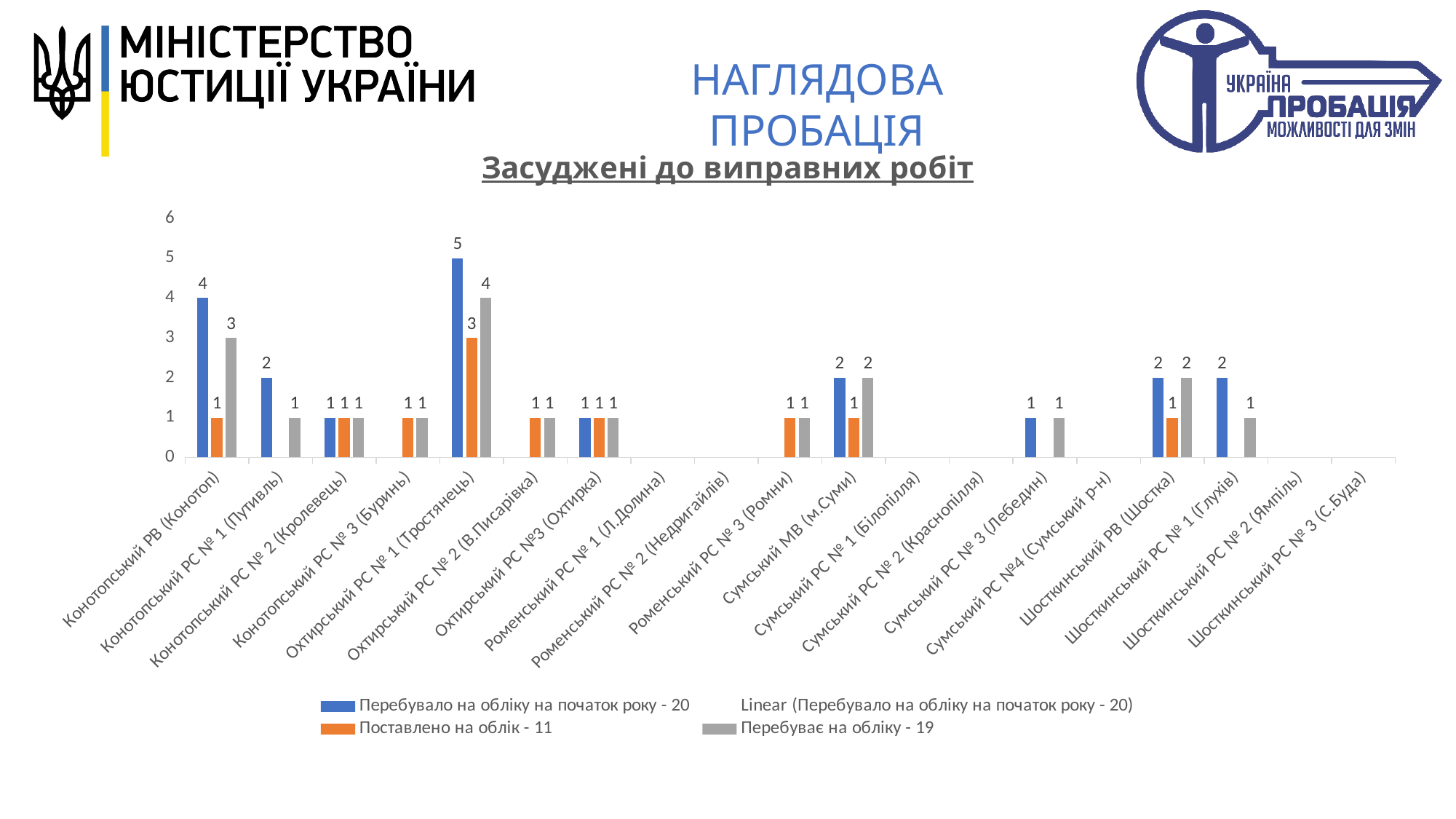
What is the value of 'Перебуває на обліку' for Конотопський РВ (Конотоп)? 3 What is the value of 'Перебувало на обліку на початок року' for Сумський МВ (м.Суми)? 2 What is the value of 'Поставлено на облік' for Охтирський РС № 1 (Тростянець)? 3 Which is larger: 'Перебувало на обліку на початок року' for Конотопський РВ (Конотоп) or for Шосткинський РВ (Шостка)? Конотопський РВ (Конотоп) Which category has the highest value for 'Перебувало на обліку на початок року'? Охтирський РС № 1 (Тростянець) How many categories are shown on the x axis? 19 What is the difference between 'Перебувало на обліку на початок року' and 'Перебуває на обліку' for Охтирський РС № 1 (Тростянець)? 1 What type of chart is shown on the slide? Bar chart What is the value of 'Перебувало на обліку на початок року' for Охтирський РС № 1 (Тростянець)? 5 Which category has the highest value for 'Перебуває на обліку'? Охтирський РС № 1 (Тростянець) What is the difference between 'Перебувало на обліку на початок року' for Конотопський РВ (Конотоп) and for Конотопський РС № 1 (Путивль)? 2 How many entries does the legend list? 4